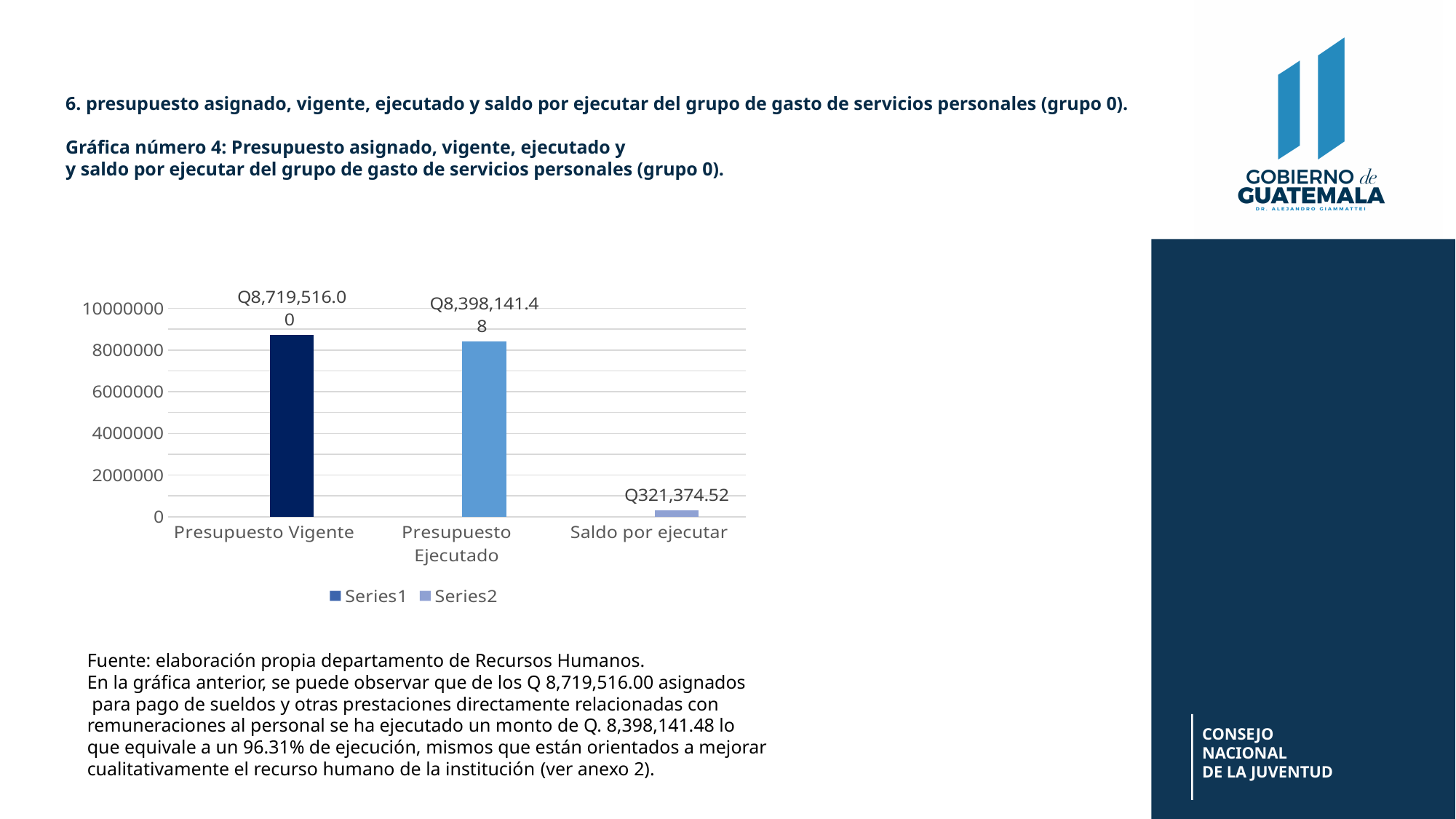
How many series does the legend list? 2 What is the value shown for Saldo por ejecutar? Q321,374.52 How many categories are shown on the x axis? 3 What is the value shown for Presupuesto Vigente? Q8,719,516.00 What kind of chart is shown on the slide? bar chart Which category has the highest value? Presupuesto Vigente Is the value for Saldo por ejecutar greater or less than 2000000? less Which category has the lowest value? Saldo por ejecutar What is the difference between Presupuesto Vigente and Presupuesto Ejecutado? Q321,374.52 What is the value shown for Presupuesto Ejecutado? Q8,398,141.48 Which is larger, Presupuesto Vigente or Presupuesto Ejecutado? Presupuesto Vigente What is the difference between Presupuesto Ejecutado and Saldo por ejecutar? Q8,076,766.96